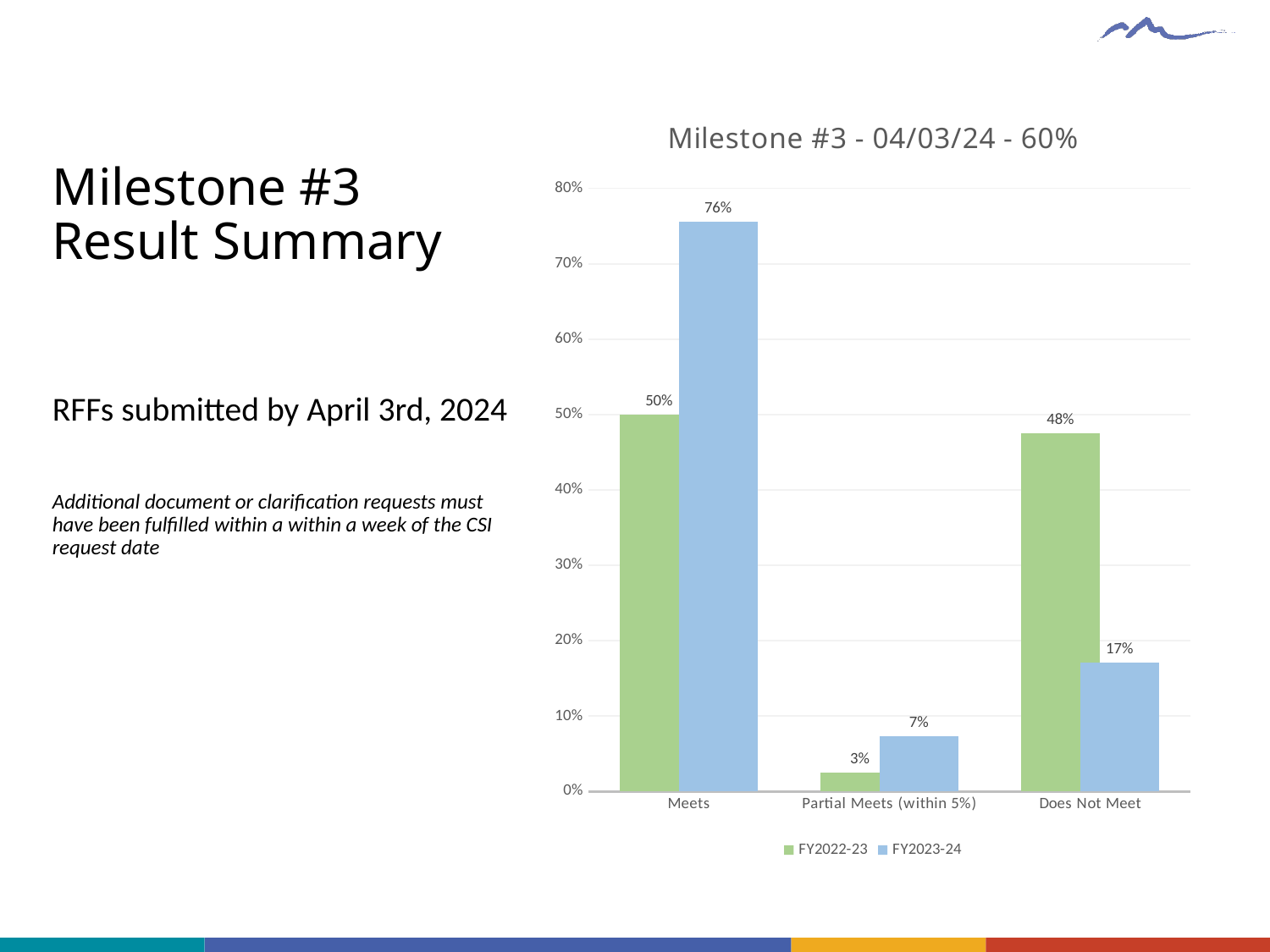
Which is larger in the Does Not Meet category, FY2022-23 or FY2023-24? FY2022-23 What is the title of the chart? Milestone #3 - 04/03/24 - 60% Which category has the highest value for FY2023-24? Meets Which category has the lowest value for FY2022-23? Partial Meets (within 5%) What is the difference between the FY2023-24 and FY2022-23 values in the Meets category? 26% What kind of chart is shown on the slide? Bar chart How many categories are shown on the x axis? 3 What is the value for FY2022-23 in the Does Not Meet category? 48% What is the value for FY2023-24 in the Meets category? 76% How many series does the legend list? 2 What is the value for FY2023-24 in the Does Not Meet category? 17% What is the value for FY2022-23 in the Partial Meets (within 5%) category? 3%